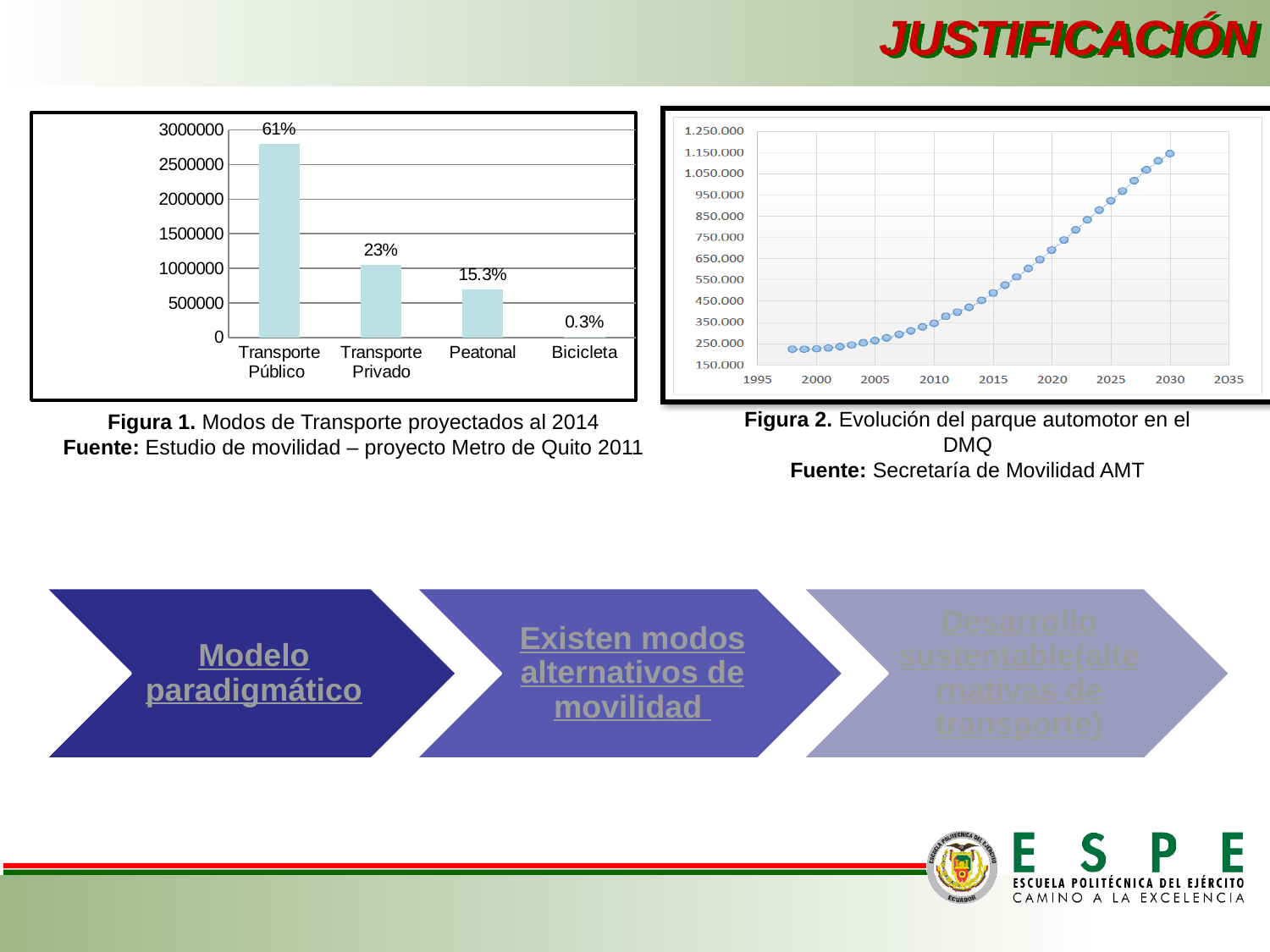
In Figura 1 (Modos de Transporte), what percentage label is shown for Bicicleta? 0.3% In Figura 1 (Modos de Transporte), which mode of transport has the highest value? Transporte Público In Figura 1 (Modos de Transporte), what is the difference in percentage points between Transporte Público and Transporte Privado? 38% In Figura 2 (Evolución del parque automotor en el DMQ), do the values rise or fall over the years? Rise In Figura 1 (Modos de Transporte), which mode of transport has the lowest value? Bicicleta In Figura 2 (Evolución del parque automotor en el DMQ), is the value for 2030 greater or less than 1.050.000? greater In Figura 1 (Modos de Transporte), how many transport modes are shown on the x axis? 4 In Figura 1 (Modos de Transporte), what percentage label is shown for Transporte Público? 61% In Figura 1 (Modos de Transporte), is the value for Transporte Público greater or less than 2500000? greater What kind of chart is Figura 1 (Modos de Transporte)? Bar chart In Figura 1 (Modos de Transporte), which is larger, Transporte Privado or Peatonal? Transporte Privado In Figura 1 (Modos de Transporte), what percentage label is shown for Peatonal? 15.3%